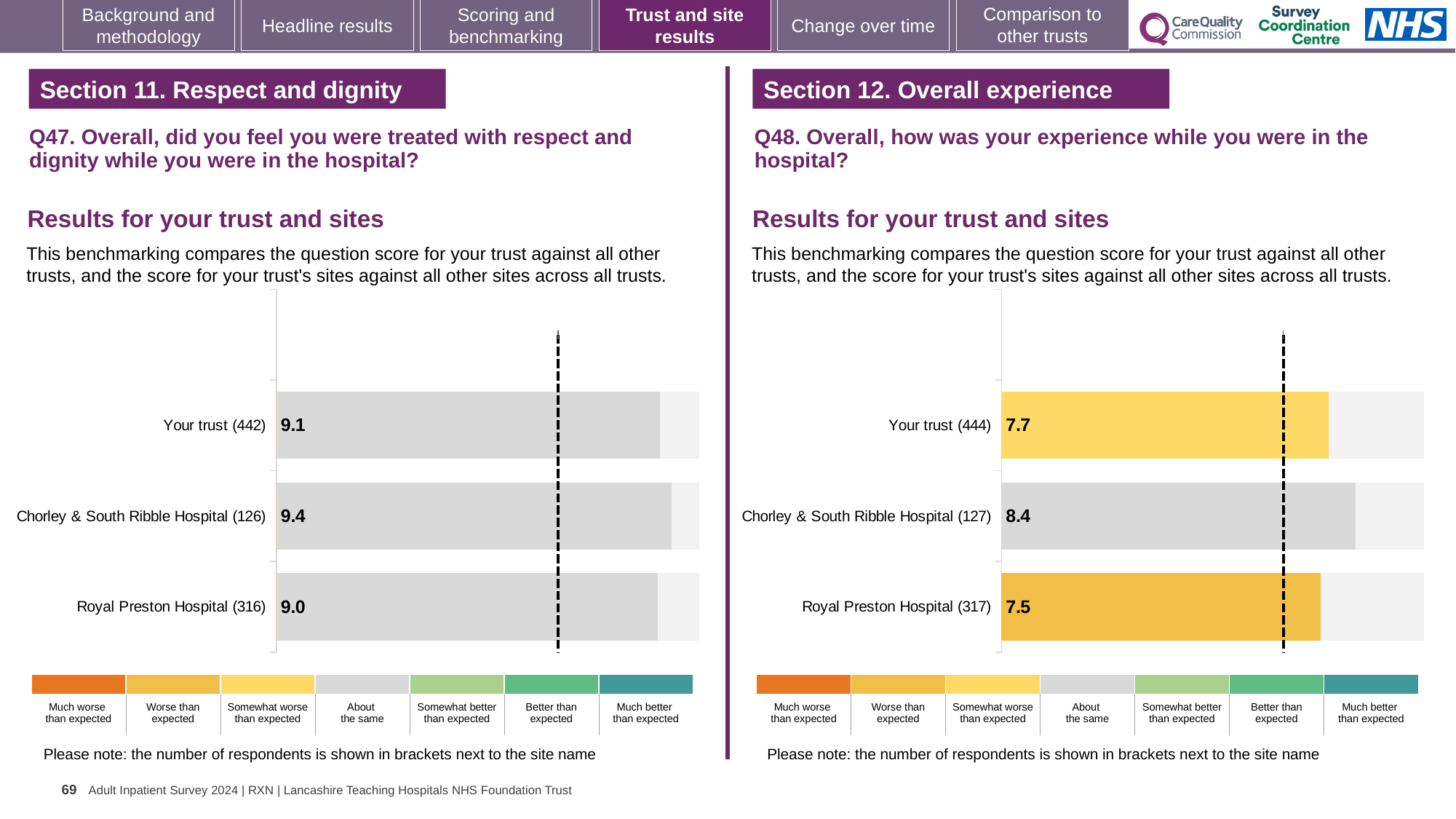
On the Q48 chart (right), which is larger, the score for Your trust or the score for Royal Preston Hospital? Your trust On the Q47 chart (left), what is the score for Your trust? 9.1 On the Q48 chart (right), which site or trust has the highest score? Chorley & South Ribble Hospital On the Q48 chart (right), what is the score for Your trust? 7.7 On the Q48 chart (right), how many bars are plotted? 3 On the Q47 chart (left), what is the score for Chorley & South Ribble Hospital? 9.4 On the Q47 chart (left), how many respondents are shown for Royal Preston Hospital? 316 On the Q47 chart (left), which site or trust has the lowest score? Royal Preston Hospital On the Q48 chart (right), which benchmark category does the colour of the Royal Preston Hospital bar correspond to? Worse than expected What kind of chart is used on the Q48 chart (right)? Bar chart On the Q48 chart (right), what is the difference between the scores for Chorley & South Ribble Hospital and Your trust? 0.7 On the Q47 chart (left), what is the difference between the scores for Chorley & South Ribble Hospital and Royal Preston Hospital? 0.4